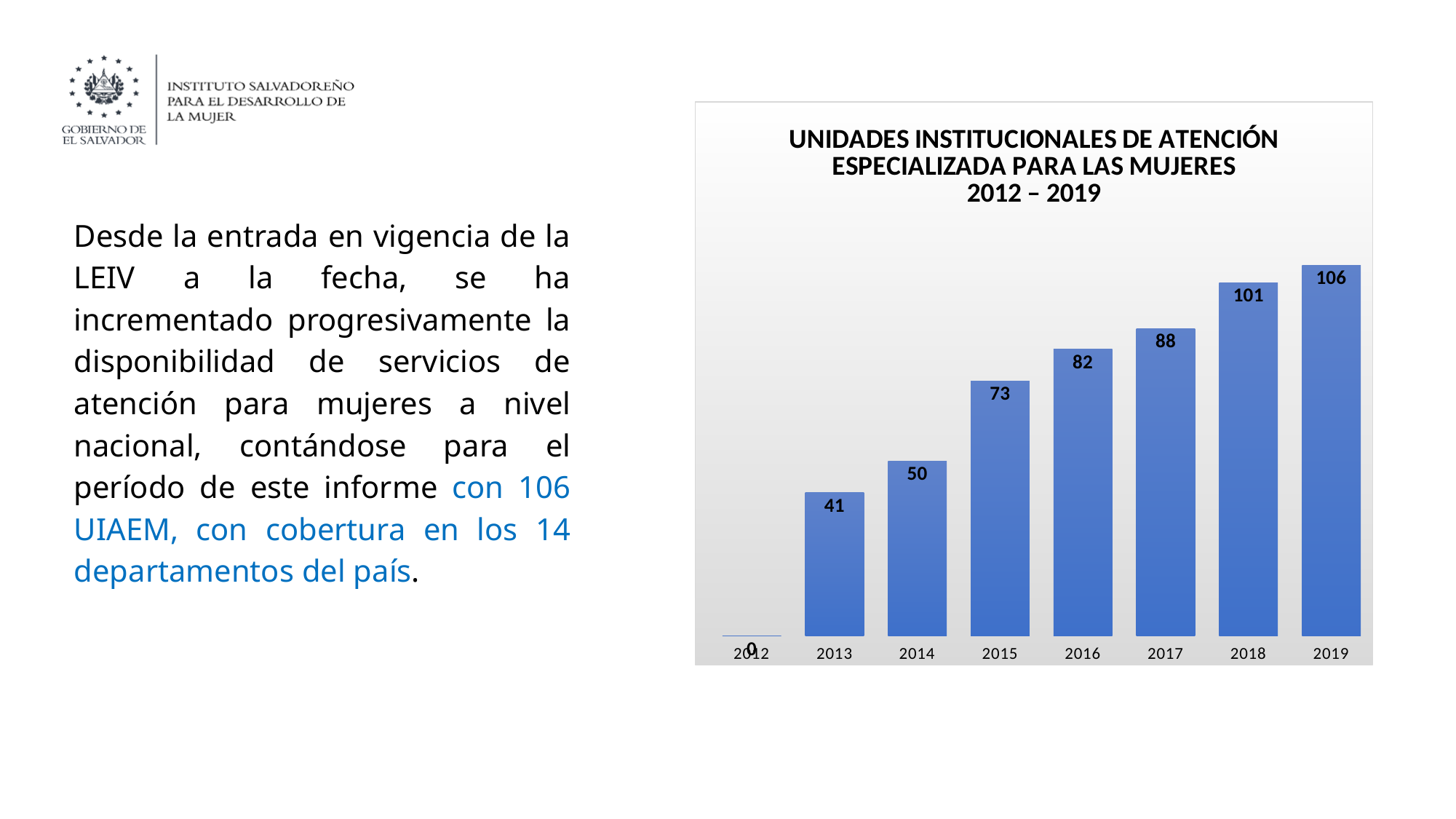
What kind of chart is this? Bar chart What is the value for 2018? 101 What is the difference between the values for 2017 and 2016? 6 What is the value for 2013? 41 What is the value for 2015? 73 Which year has the lowest value? 2012 Which year has the highest value? 2019 What is the title of the chart? UNIDADES INSTITUCIONALES DE ATENCIÓN ESPECIALIZADA PARA LAS MUJERES 2012 – 2019 How many years are shown on the x axis? 8 Do the values rise or fall from 2012 to 2019? Rise What is the difference between the values for 2019 and 2013? 65 Which is larger, the value for 2014 or the value for 2016? 2016